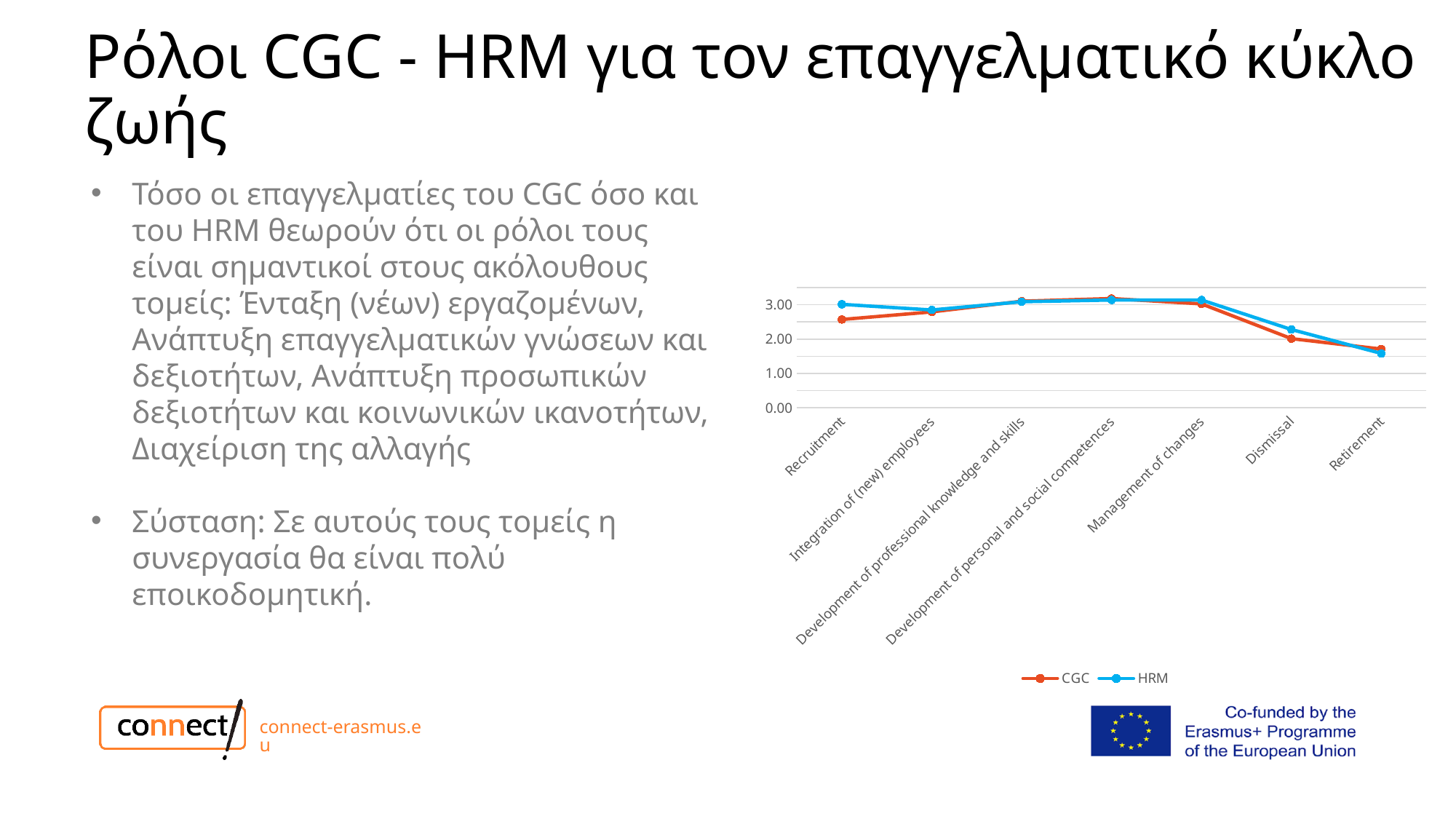
Is the HRM value for Retirement greater or less than 2.00? less Which category has the lowest CGC value? Retirement Which two series are listed in the chart legend? CGC and HRM Do the values for both series rise or fall from Management of changes to Retirement? fall How many categories are plotted along the x axis of the chart? 7 Is the CGC value for Recruitment greater or less than 3.00? less Is the CGC value for Retirement greater or less than 2.00? less What kind of chart is shown on the slide? line chart For Recruitment, which series has the higher value, CGC or HRM? HRM How many series does the chart legend list? 2 For Dismissal, which series has the higher value, CGC or HRM? HRM